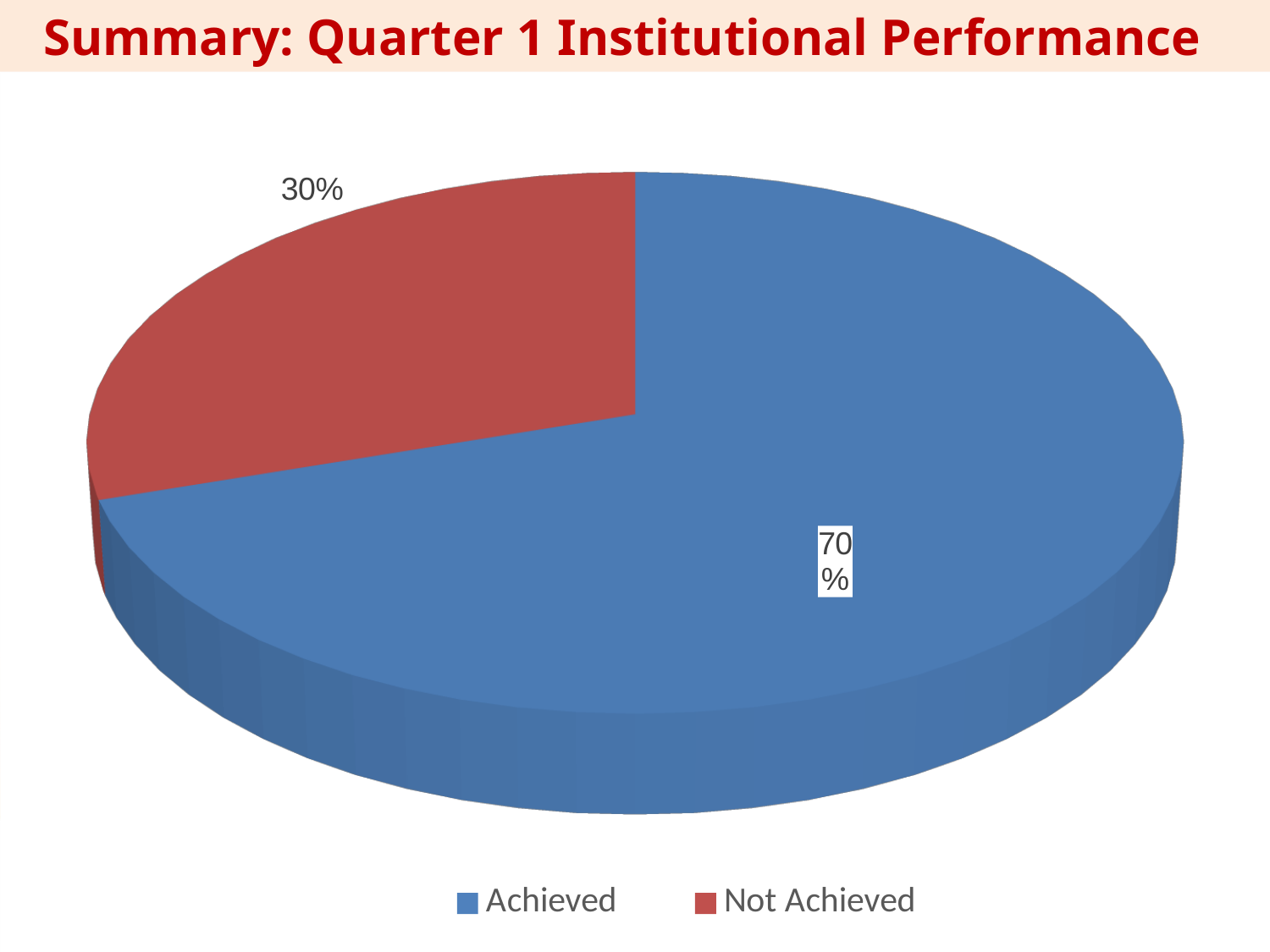
What kind of chart is shown on the slide? pie chart What share of the pie is labelled Achieved? 70% What is the title of the slide? Summary: Quarter 1 Institutional Performance Which is larger, the Achieved slice or the Not Achieved slice? Achieved Which slice is the smallest? Not Achieved What share of the pie is labelled Not Achieved? 30% How many slices does the pie chart have? 2 How many entries does the legend list? 2 What colour is the Not Achieved slice? red What is the difference between the Achieved and Not Achieved shares? 40% Which slice is the largest? Achieved